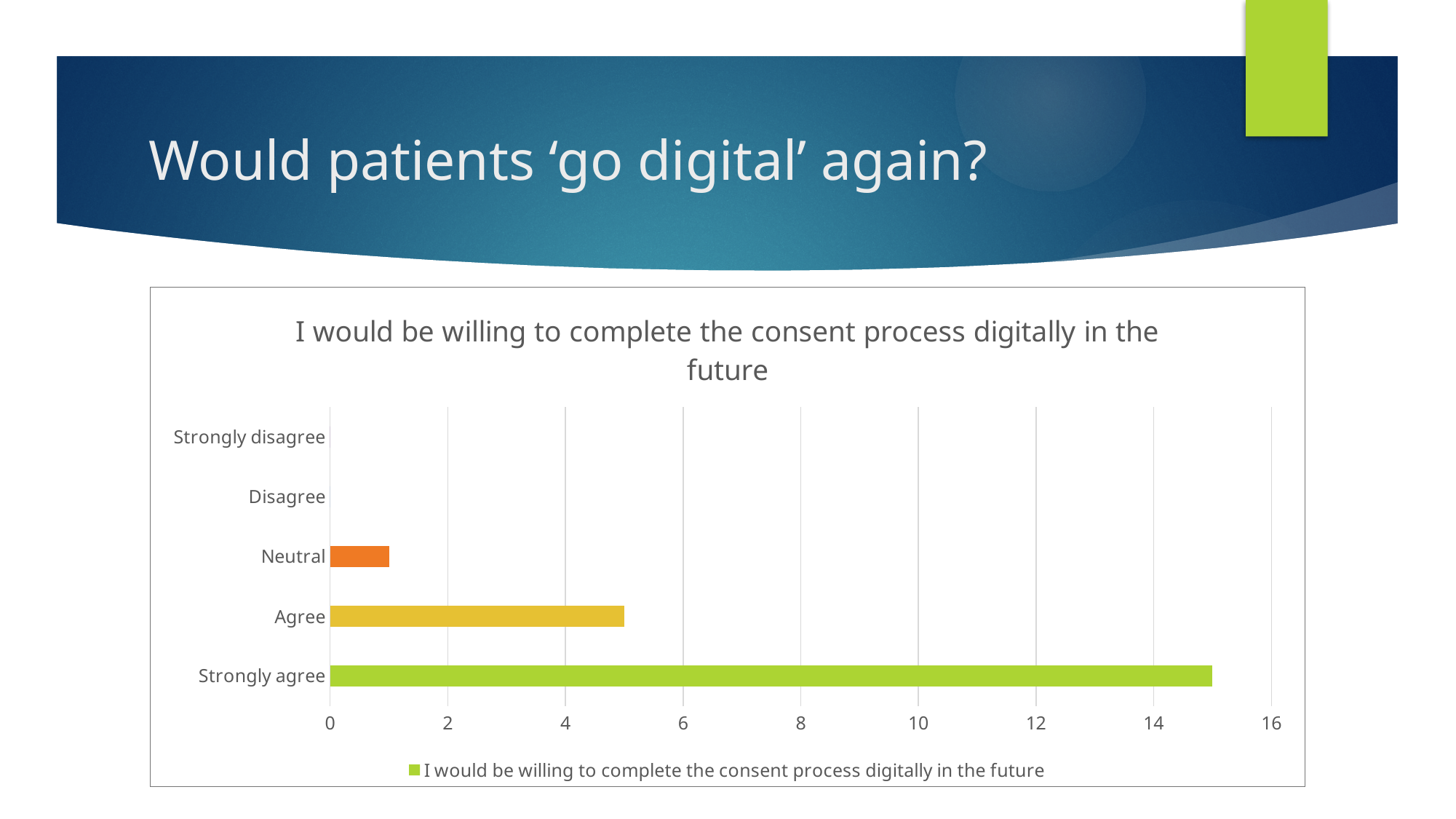
What colour is the bar for Strongly agree? Green Which category has the highest value? Strongly agree Is the value for Agree greater or less than 6? less What is the title of the chart? I would be willing to complete the consent process digitally in the future What kind of chart is shown on the slide? Bar chart Is the value for Strongly agree greater or less than 14? greater Which is larger, the value for Agree or the value for Neutral? Agree Is the value for Neutral greater or less than 2? less How many series does the legend list? 1 How many categories are shown on the chart? 5 Which is larger, the value for Strongly agree or the value for Agree? Strongly agree